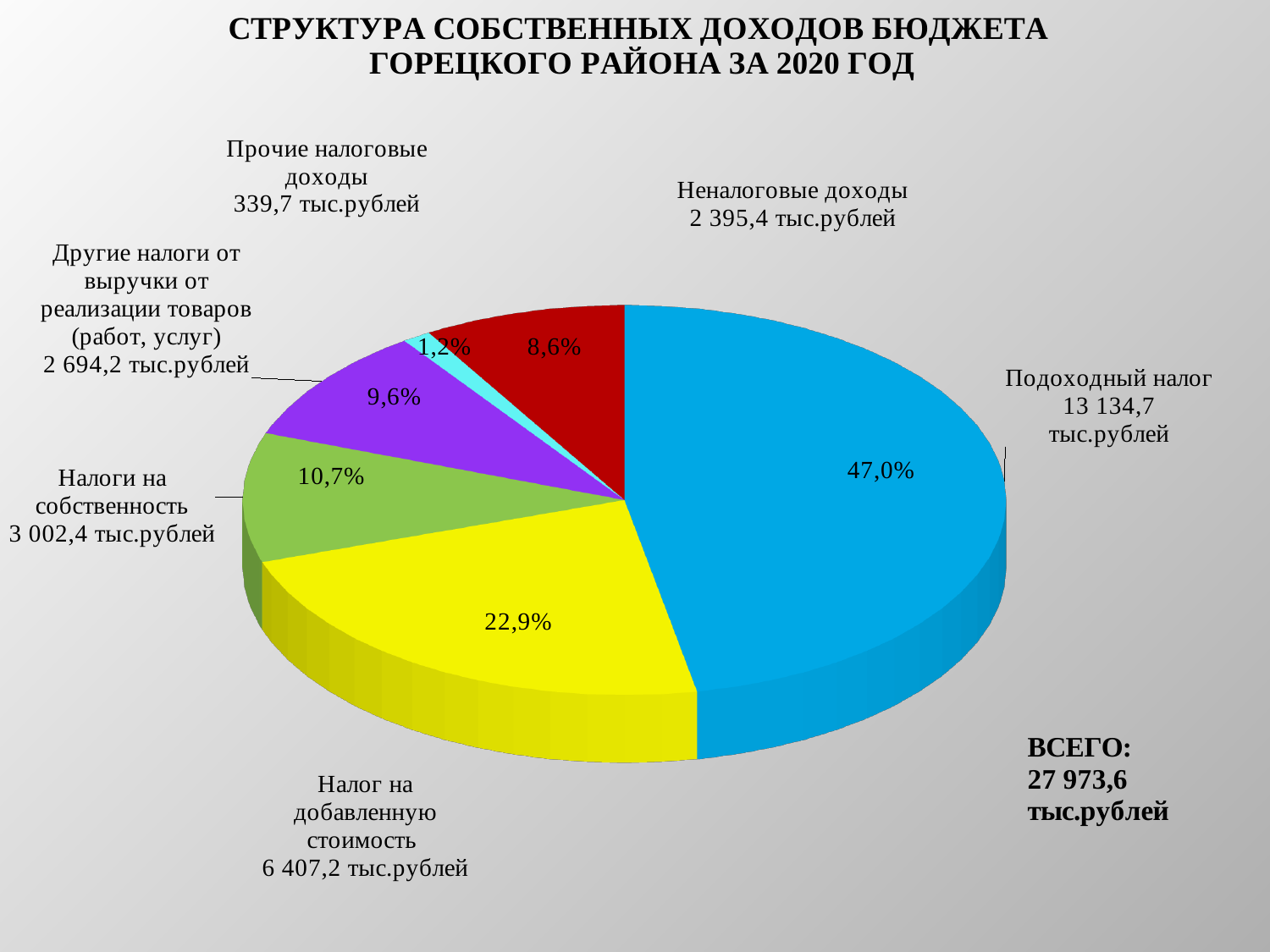
What total (ВСЕГО) is shown on the slide? 27 973,6 тыс.рублей What share of the pie does Налог на добавленную стоимость have? 22,9% Which category has the largest share of the pie? Подоходный налог How many slices does the pie chart have? 6 What is the value for Неналоговые доходы? 2 395,4 тыс.рублей What is the difference in percentage points between the share for Подоходный налог and the share for Налог на добавленную стоимость? 24,1 What is the value for Налоги на собственность? 3 002,4 тыс.рублей What kind of chart is shown on the slide? pie chart Which category has the smallest share of the pie? Прочие налоговые доходы Which is larger: the share for Налоги на собственность or the share for Неналоговые доходы? Налоги на собственность What share of the pie does Подоходный налог have? 47,0% What is the value for Прочие налоговые доходы? 339,7 тыс.рублей